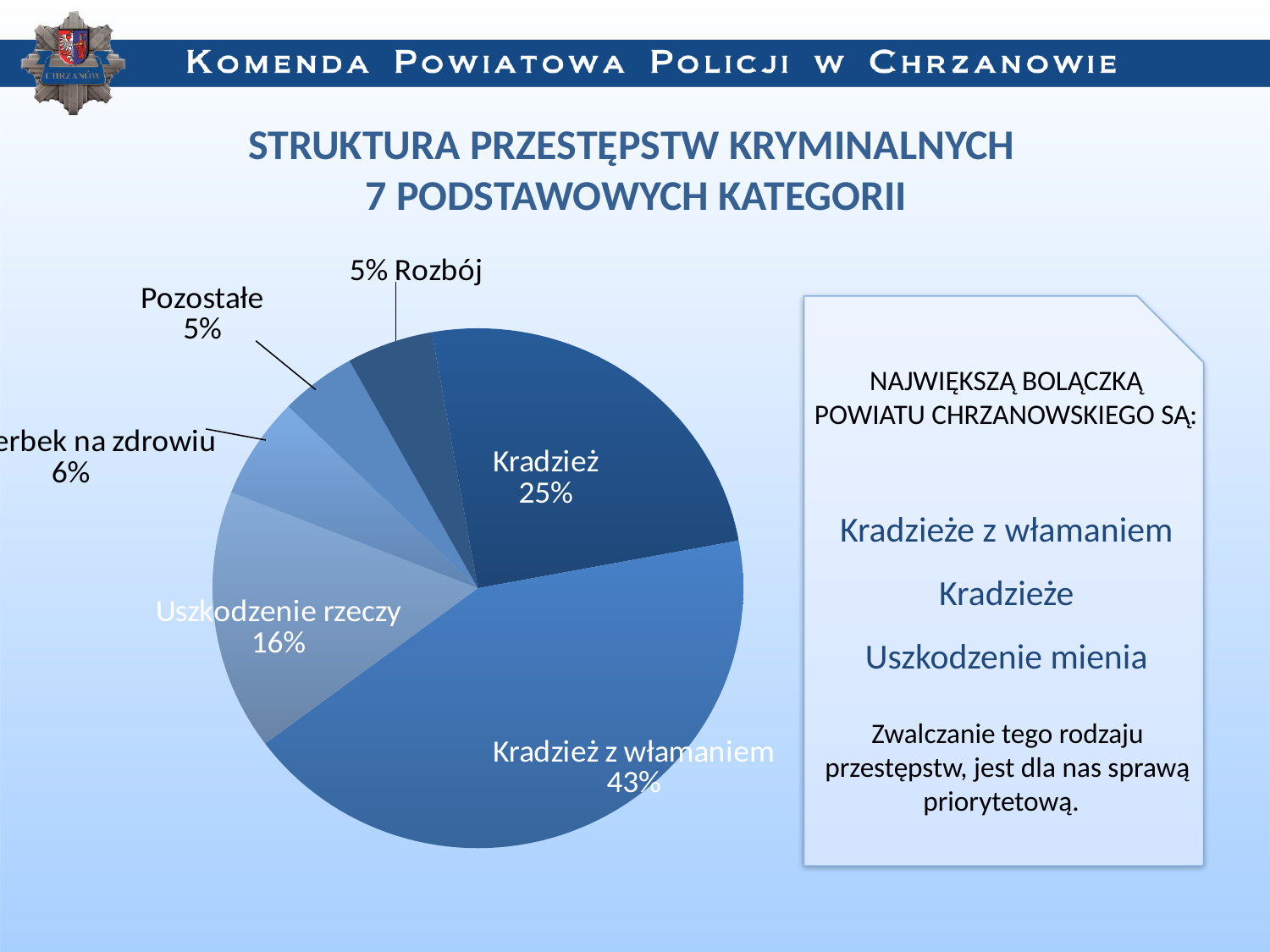
What is the difference in percentage points between Kradzież and Uszkodzenie rzeczy? 9 What percentage is shown for Uszkodzenie rzeczy? 16% What percentage is shown for Kradzież? 25% What is the difference in percentage points between Kradzież z włamaniem and Kradzież? 18 What share of the pie does Kradzież z włamaniem represent? 43% What type of chart is shown on the slide? pie chart Which is larger, the slice for Kradzież or the slice for Uszkodzenie rzeczy? Kradzież Which category has the largest slice of the pie? Kradzież z włamaniem What percentage is shown for Pozostałe? 5% How many slices does the pie chart have? 6 What percentage is shown for Rozbój? 5% What is the title of the slide containing the chart? STRUKTURA PRZESTĘPSTW KRYMINALNYCH 7 PODSTAWOWYCH KATEGORII